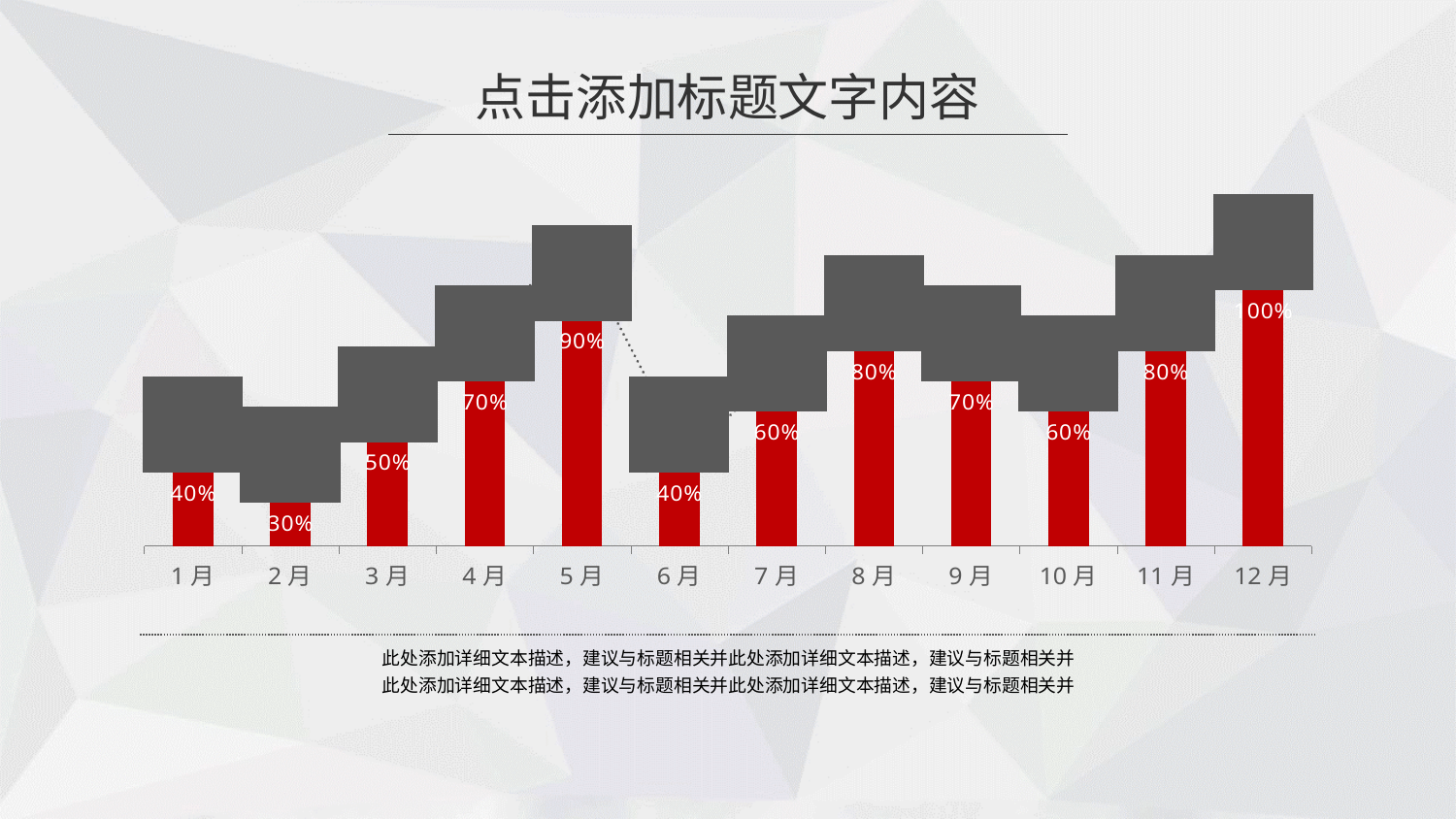
What colour are the bars in the chart? red What is the difference between the values for 5月 and 6月? 50% What is the value for 5月? 90% What kind of chart is shown on the slide? bar chart Which month has the lowest value? 2月 What is the value for 2月? 30% How many months are shown on the x axis? 12 Which is larger, the value for 3月 or the value for 7月? 7月 Which month has the highest value? 12月 What is the difference between the values for 4月 and 1月? 30% What is the value for 8月? 80% What is the value for 10月? 60%